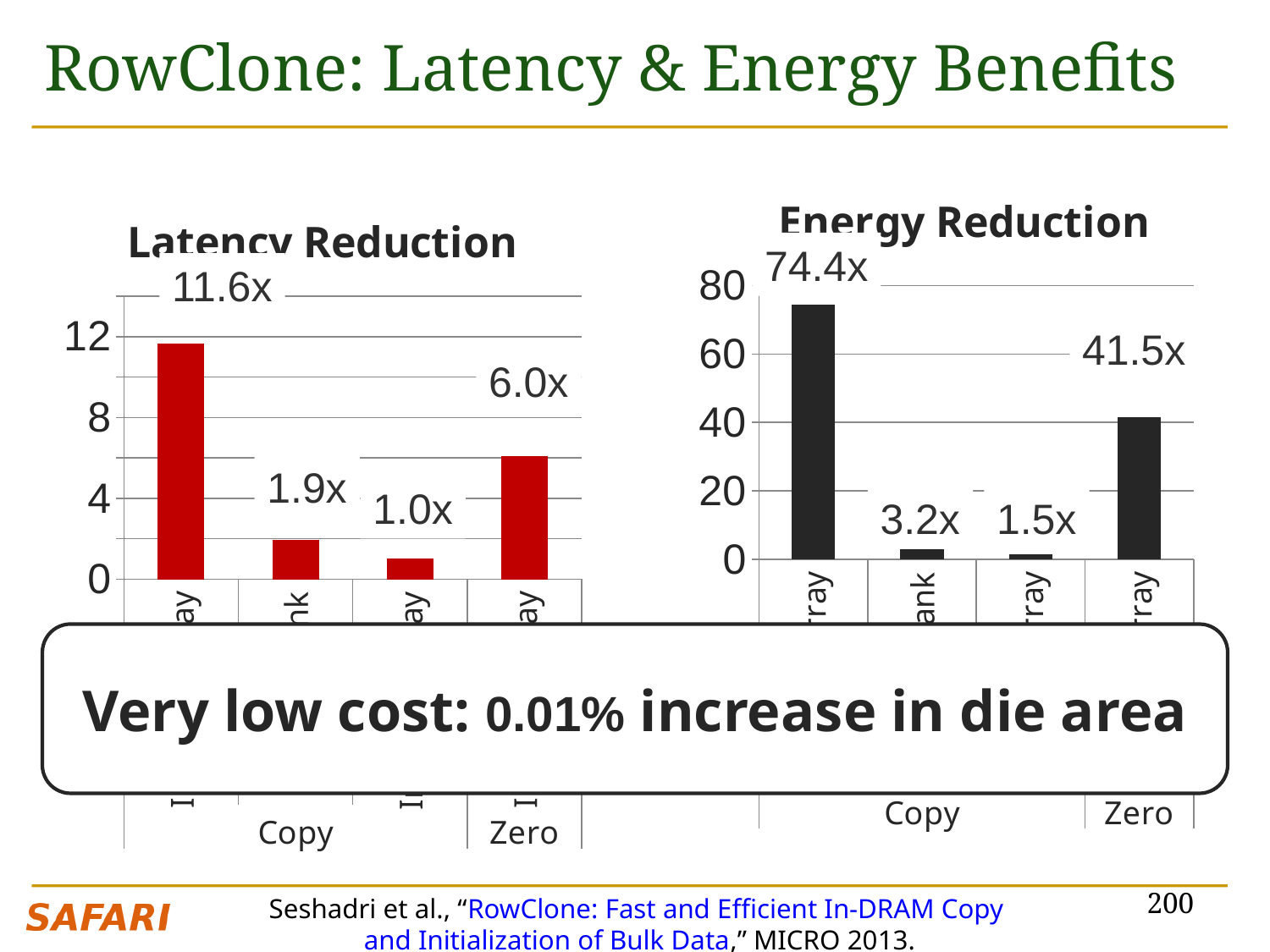
In the Latency Reduction chart, what is the difference between the first bar (11.6x) and the Zero bar (6.0x)? 5.6x In the Energy Reduction chart, what is the difference between the first bar (74.4x) and the Zero bar (41.5x)? 32.9x In the Energy Reduction chart, what is the lowest value shown? 1.5x In the Energy Reduction chart, is the value of the first bar greater or less than 60? greater In the Latency Reduction chart, what is the value of the bar in the Zero group? 6.0x What kind of chart is the Latency Reduction chart? bar chart How many bars are plotted in the Latency Reduction chart? 4 In the Energy Reduction chart, what is the highest value shown? 74.4x In the Energy Reduction chart, what is the value of the bar in the Zero group? 41.5x In the Latency Reduction chart, what is the lowest value shown? 1.0x In the Latency Reduction chart, what is the highest value shown? 11.6x What colour are the bars in the Latency Reduction chart? red